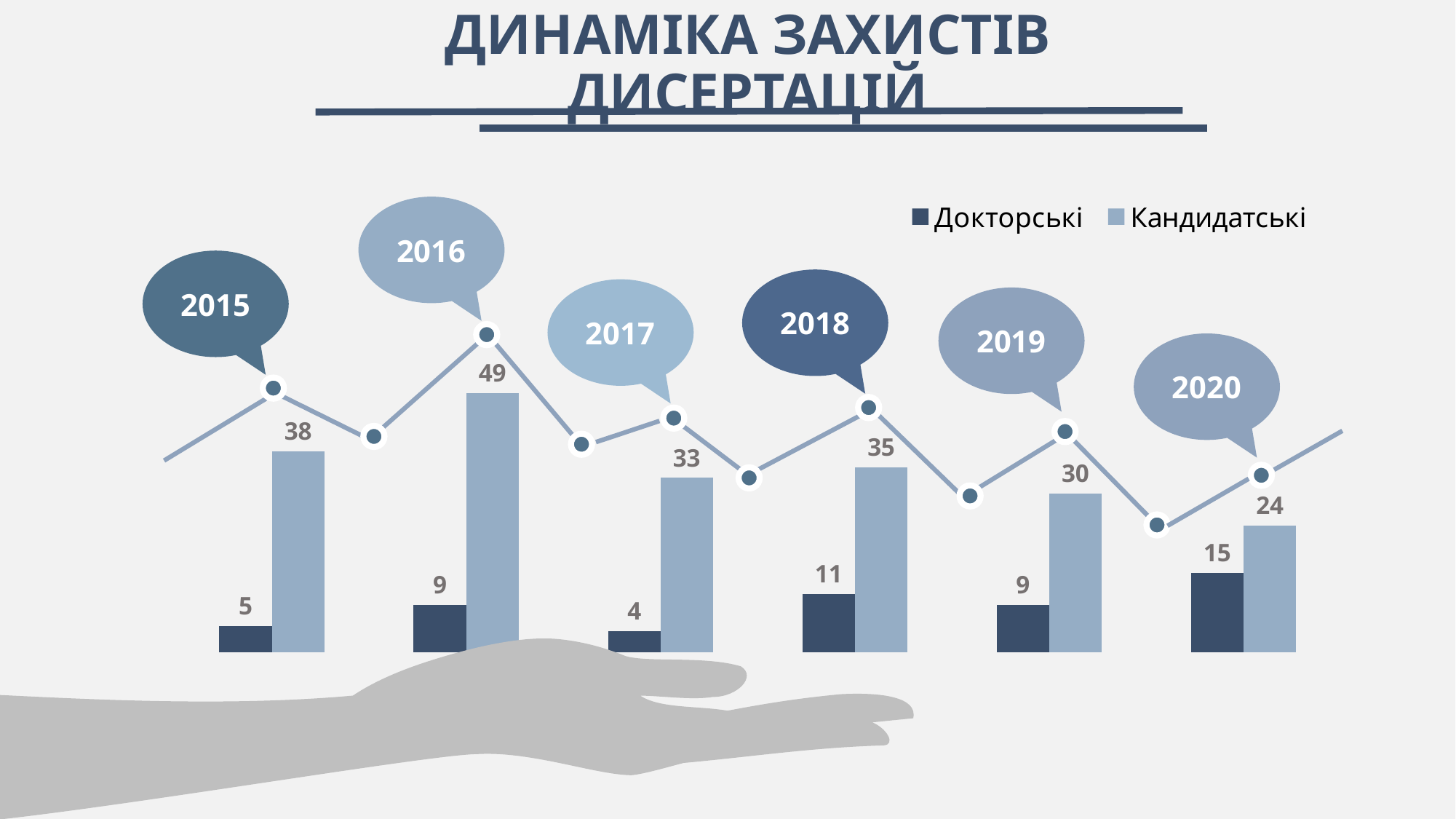
What kind of chart is shown on the slide? Bar chart How many years are shown on the chart? 6 What is the value for Кандидатські in 2016? 49 How many series does the legend list? 2 In which year is the Докторські value lowest? 2017 In which year is the Кандидатські value lowest? 2020 What is the difference between the Кандидатські values for 2016 and 2017? 16 What is the value for Докторські in 2018? 11 Which is larger: the Кандидатські value for 2018 or for 2019? 2018 What is the value for Кандидатські in 2020? 24 In which year is the Докторські value highest? 2020 What is the difference between the Докторські values for 2020 and 2015? 10